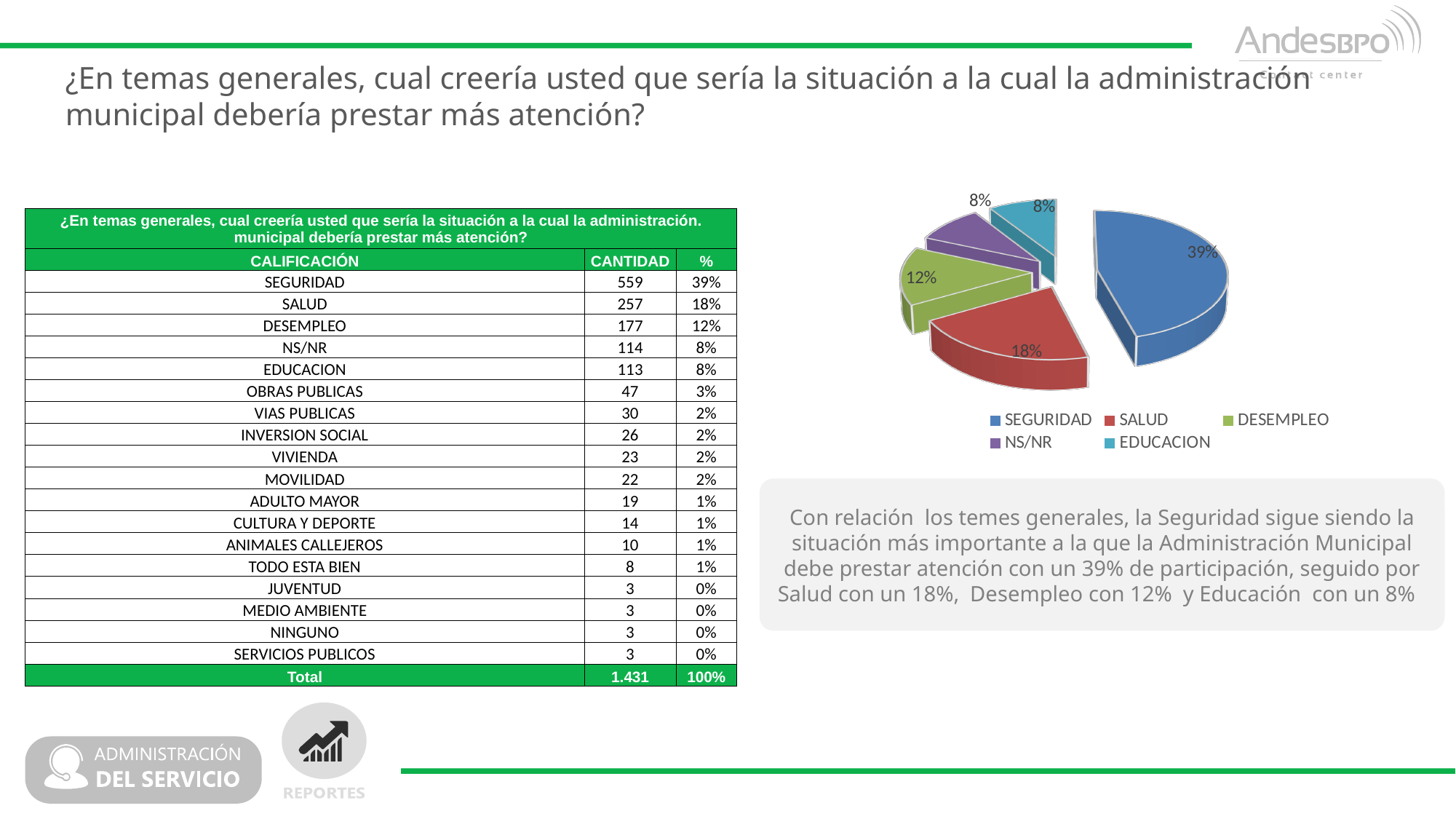
What share of the pie chart does DESEMPLEO represent? 12% In the pie chart, what is the difference in percentage points between SEGURIDAD and SALUD? 21% What share of the pie chart does SALUD represent? 18% What share of the pie chart does EDUCACION represent? 8% Which category has the largest slice in the pie chart? SEGURIDAD How many slices does the pie chart have? 5 How many entries does the pie chart legend list? 5 What kind of chart is shown on the slide? pie chart In the pie chart, which is larger, SALUD or DESEMPLEO? SALUD What colour is the SEGURIDAD slice in the pie chart? blue In the pie chart, what is the difference in percentage points between DESEMPLEO and NS/NR? 4%